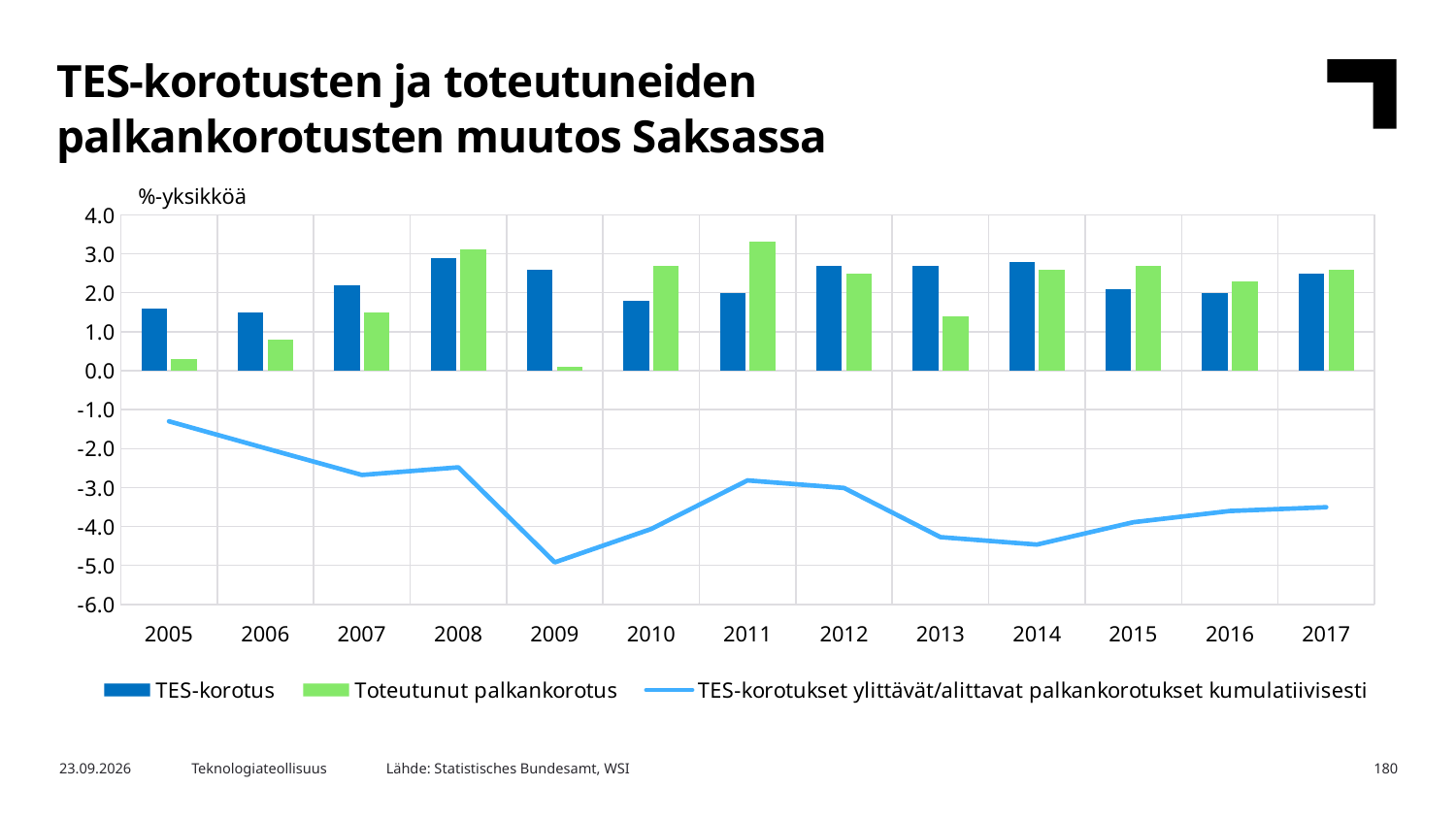
Is the value of the cumulative line for 2009 greater or less than -4.0? less How many years are shown on the x axis? 13 In which year is the Toteutunut palkankorotus bar the lowest? 2009 In which year is the Toteutunut palkankorotus bar the highest? 2011 In 2011, which is larger: TES-korotus or Toteutunut palkankorotus? Toteutunut palkankorotus Is the Toteutunut palkankorotus value for 2009 greater or less than 1.0? less In which year does the line TES-korotukset ylittävät/alittavat palkankorotukset kumulatiivisesti reach its lowest point? 2009 What kind of chart is shown on the slide? A combined bar and line chart What unit label is shown above the y axis? %-yksikköä In 2005, which is larger: TES-korotus or Toteutunut palkankorotus? TES-korotus How many series does the legend list? 3 Is the TES-korotus value for 2008 greater or less than 2.0? greater